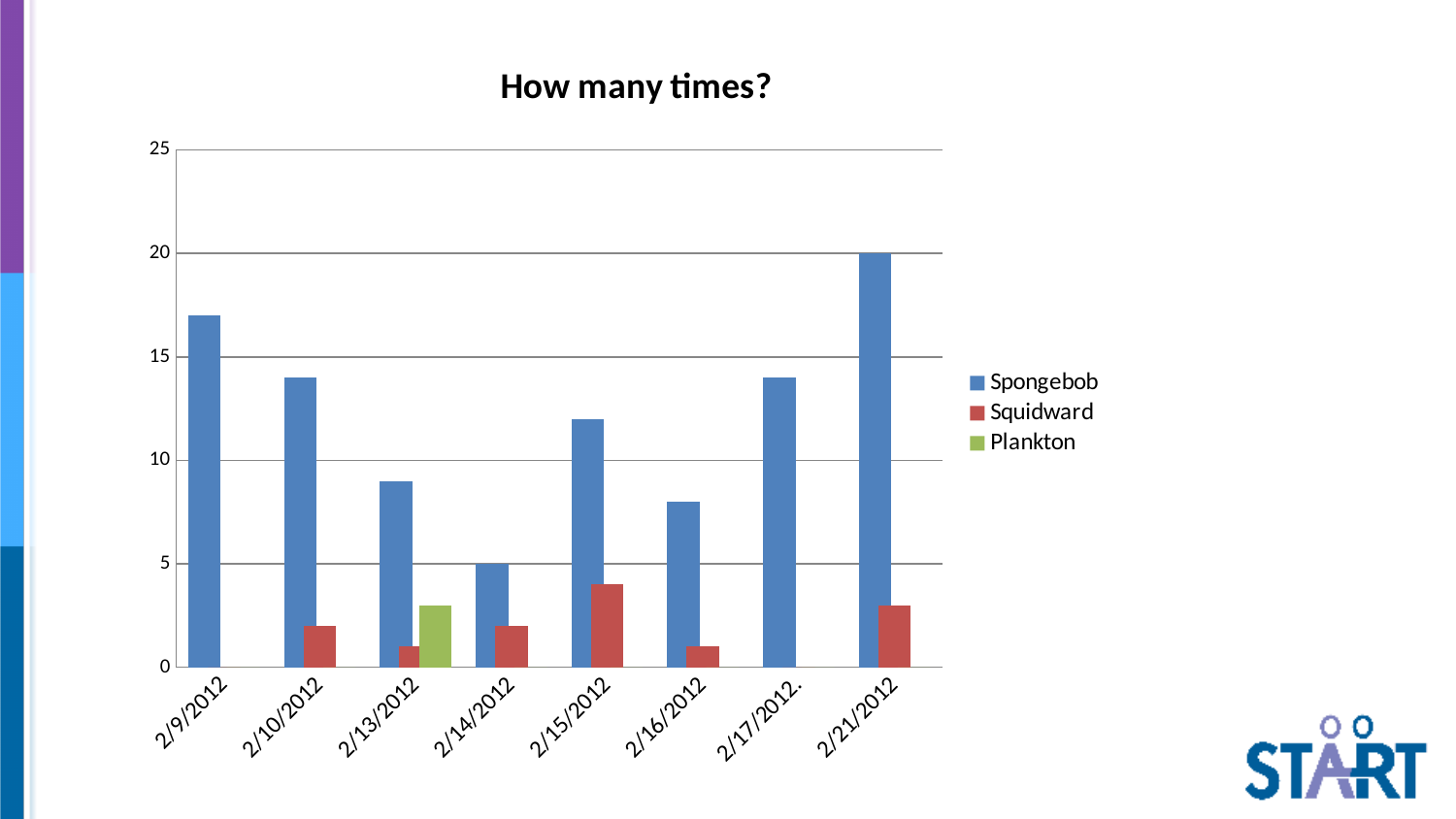
Is the Spongebob value for 2/16/2012 greater or less than 10? less What is the Spongebob value for 2/14/2012? 5 On which date is the Spongebob value lowest? 2/14/2012 What is the Spongebob value for 2/21/2012? 20 What is the title of the chart? How many times? How many series does the legend list? 3 On which date does the Plankton series have a bar? 2/13/2012 On which date is the Spongebob value highest? 2/21/2012 Is the Spongebob value for 2/9/2012 greater or less than 15? greater What kind of chart is shown on the slide? bar chart Which is larger, the Spongebob value for 2/9/2012 or for 2/10/2012? 2/9/2012 How many dates are shown along the x axis? 8